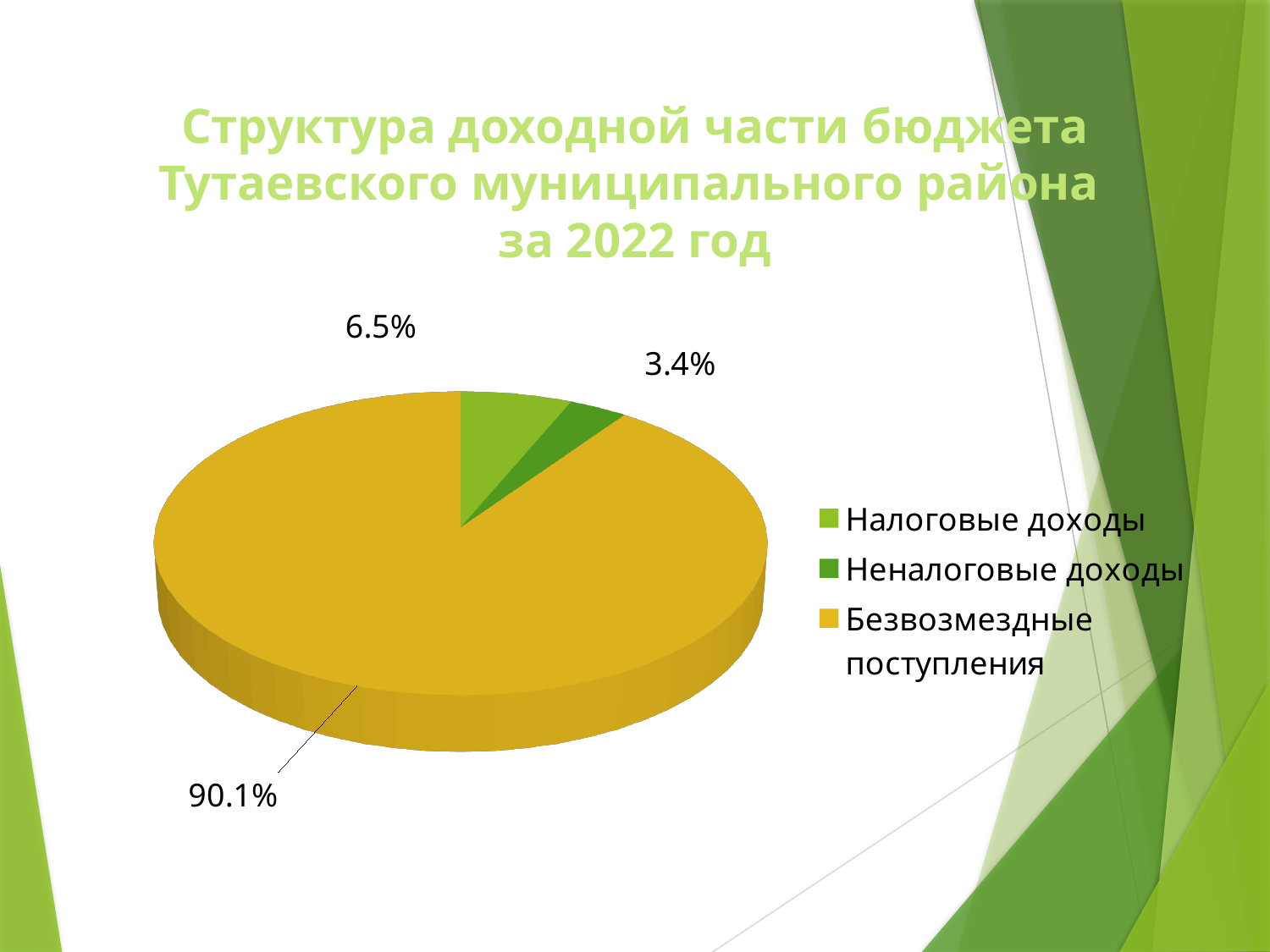
Which category has the largest slice of the pie? Безвозмездные поступления Which is larger, the share of Налоговые доходы or the share of Неналоговые доходы? Налоговые доходы What share of the pie does Неналоговые доходы have? 3.4% How many entries does the legend list? 3 What is the title of the chart on the slide? Структура доходной части бюджета Тутаевского муниципального района за 2022 год Which category has the smallest slice of the pie? Неналоговые доходы What share of the pie does Безвозмездные поступления have? 90.1% What colour is the slice for Безвозмездные поступления? yellow What share of the pie does Налоговые доходы have? 6.5% What kind of chart is shown on the slide? pie chart What is the difference between the shares of Налоговые доходы and Неналоговые доходы? 3.1% How many slices does the pie chart have? 3